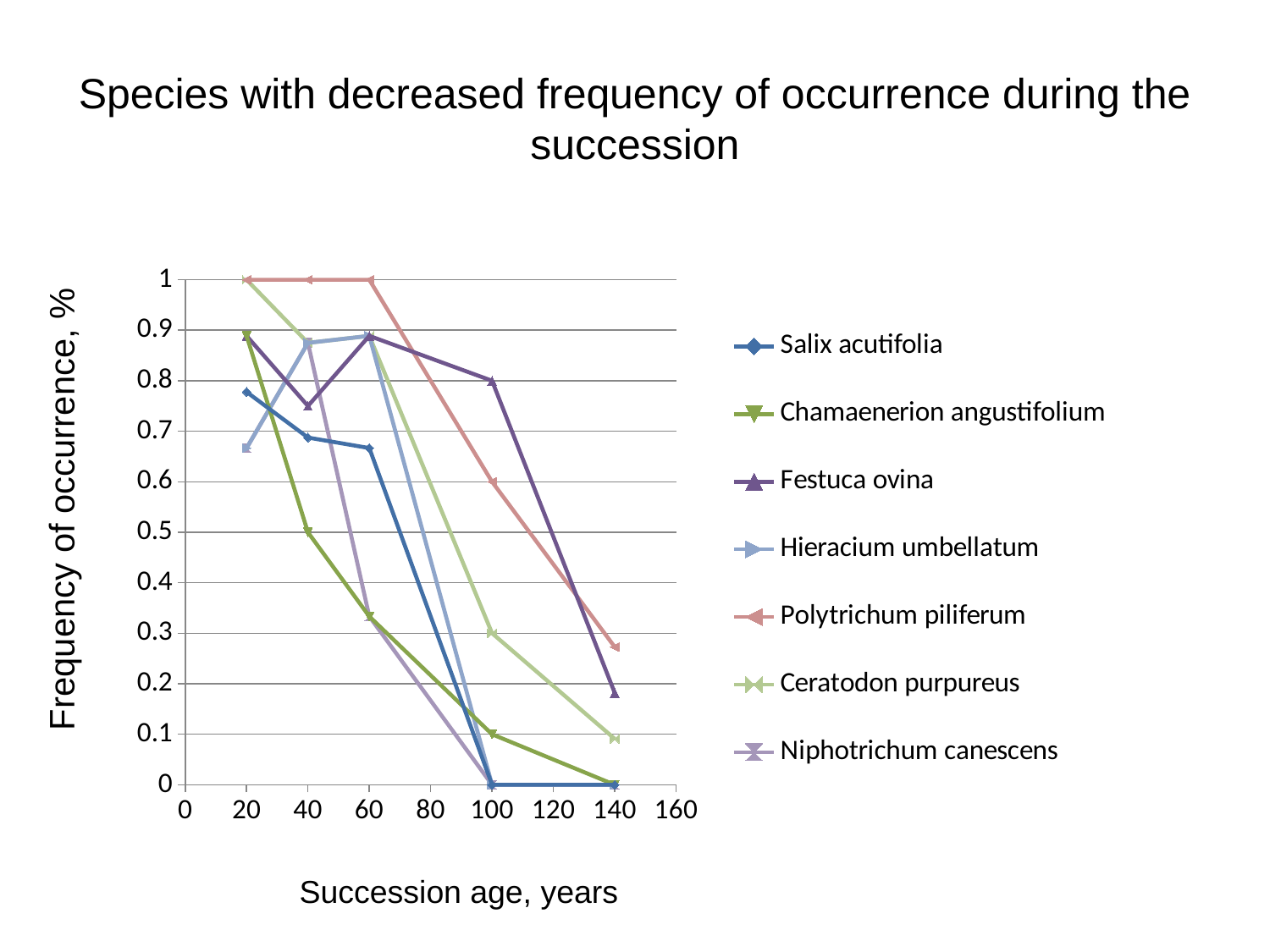
What is the label of the x axis? Succession age, years At succession age 40 years, which is larger: the value for Festuca ovina or the value for Chamaenerion angustifolium? Festuca ovina What is the title of the chart? Species with decreased frequency of occurrence during the succession Which series has the highest frequency of occurrence at succession age 140 years? Polytrichum piliferum Does the frequency of occurrence for Ceratodon purpureus rise or fall as succession age increases? fall What is the frequency of occurrence for Festuca ovina at succession age 100 years? 0.8 What kind of chart is shown on the slide? line chart Which series has the lowest frequency of occurrence at succession age 20 years? Hieracium umbellatum and Niphotrichum canescens (tied) How many series does the legend list? 7 What is the frequency of occurrence for Polytrichum piliferum at succession age 20 years? 1 Is the value for Salix acutifolia at succession age 60 years greater or less than 0.6? greater What is the frequency of occurrence for Salix acutifolia at succession age 100 years? 0